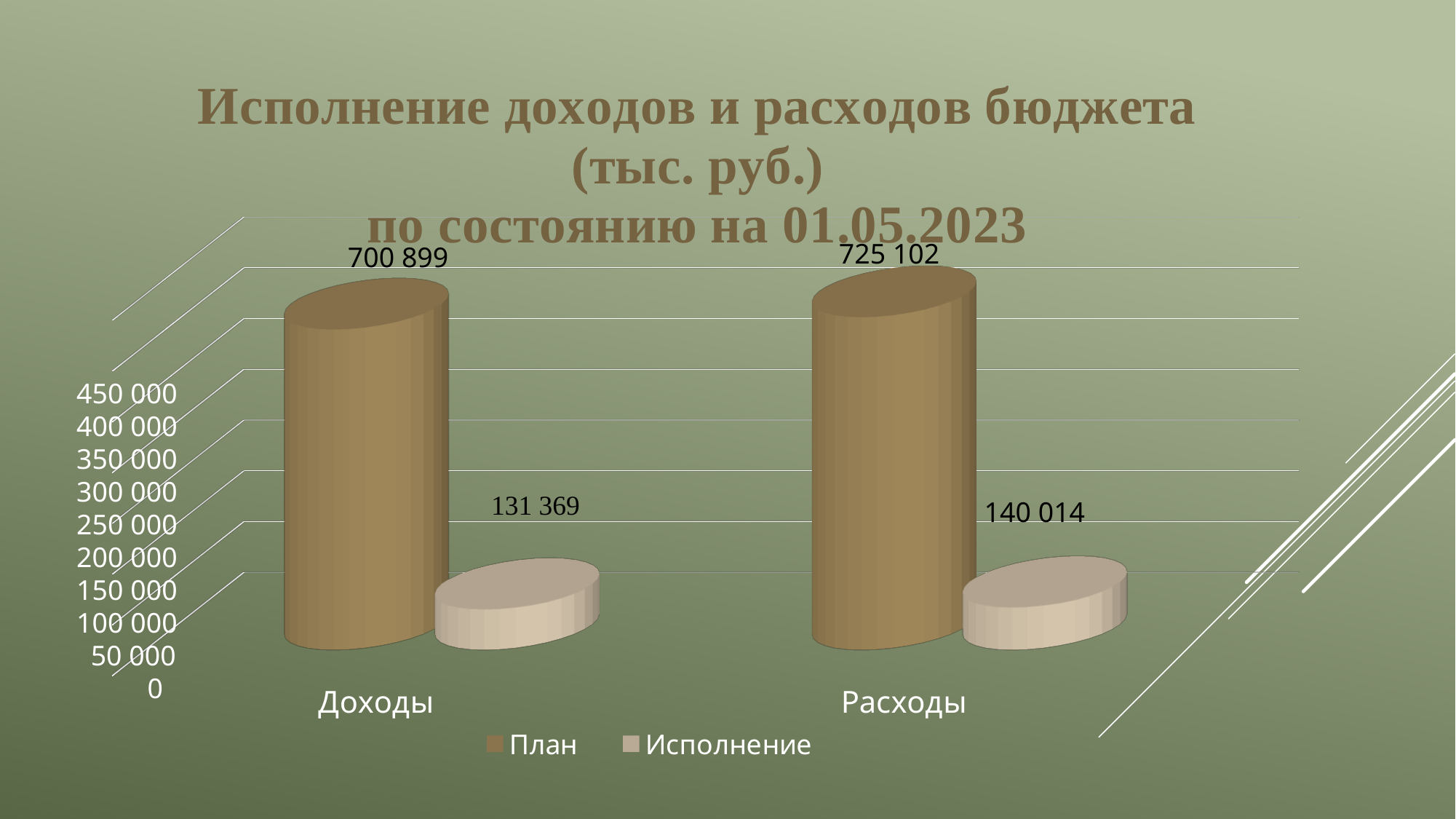
What kind of chart is shown on the slide? Bar chart What is the difference between the Исполнение values for Расходы and Доходы? 8 645 What is the План value for Доходы? 700 899 What is the difference between the План values for Расходы and Доходы? 24 203 Which category has the lowest Исполнение value? Доходы What is the Исполнение value for Доходы? 131 369 What is the difference between the План and Исполнение values for Доходы? 569 530 What is the Исполнение value for Расходы? 140 014 What is the План value for Расходы? 725 102 How many series does the legend list? 2 How many categories are shown on the x axis? 2 Which category has the higher План value, Доходы or Расходы? Расходы